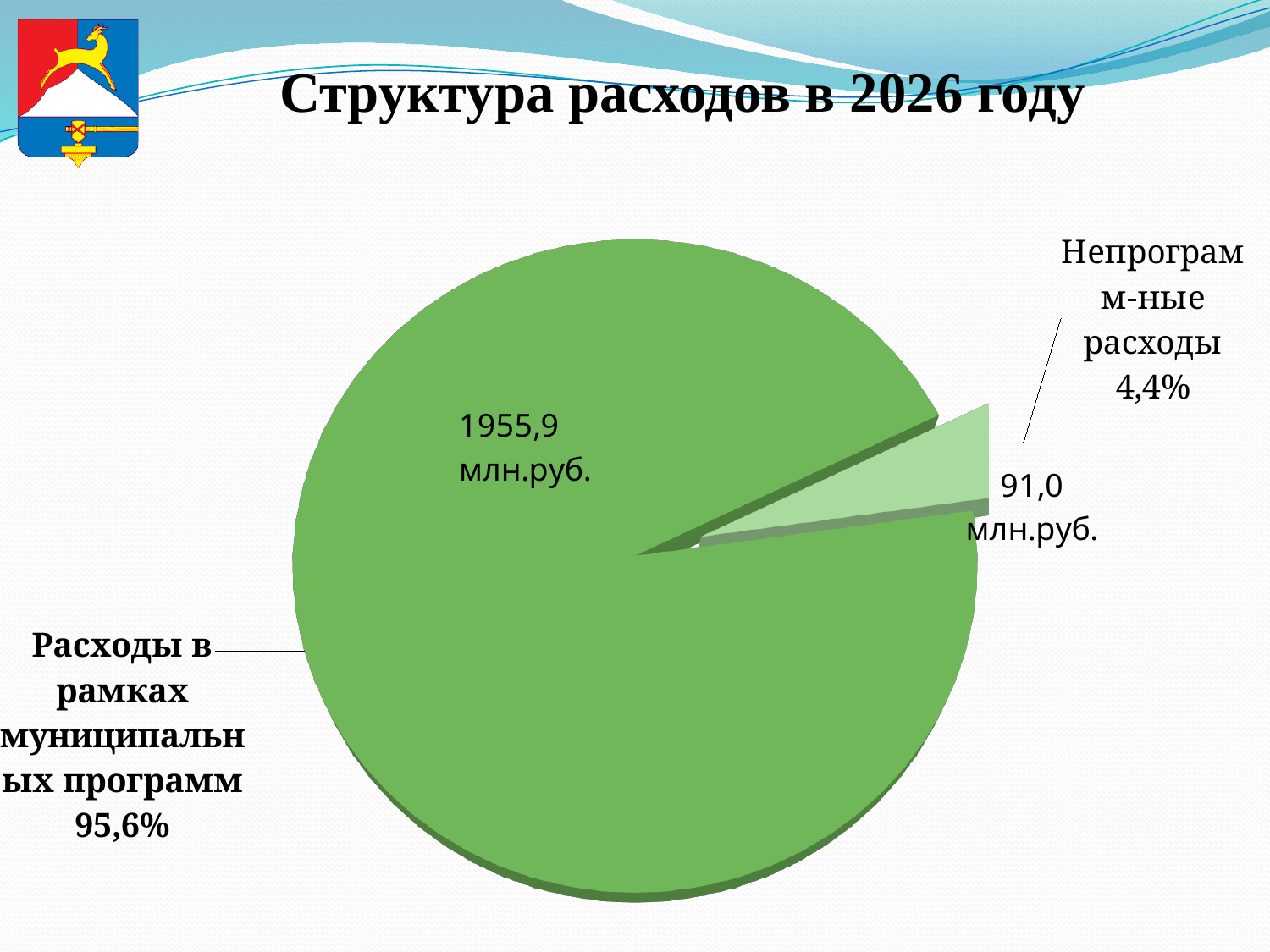
What kind of chart is shown on the slide? pie chart What share of the pie is Расходы в рамках муниципальных программ? 95,6% What share of the pie is Непрограммные расходы? 4,4% Which slice is the largest? Расходы в рамках муниципальных программ What is the total of the two slices in млн.руб.? 2046,9 млн.руб. What is the difference in млн.руб. between Расходы в рамках муниципальных программ and Непрограммные расходы? 1864,9 млн.руб. How many slices does the pie chart have? 2 What is the title of the chart? Структура расходов в 2026 году What is the value for Непрограммные расходы? 91,0 млн.руб. Which is larger, Расходы в рамках муниципальных программ or Непрограммные расходы? Расходы в рамках муниципальных программ Which slice is the smallest? Непрограммные расходы What is the value for Расходы в рамках муниципальных программ? 1955,9 млн.руб.